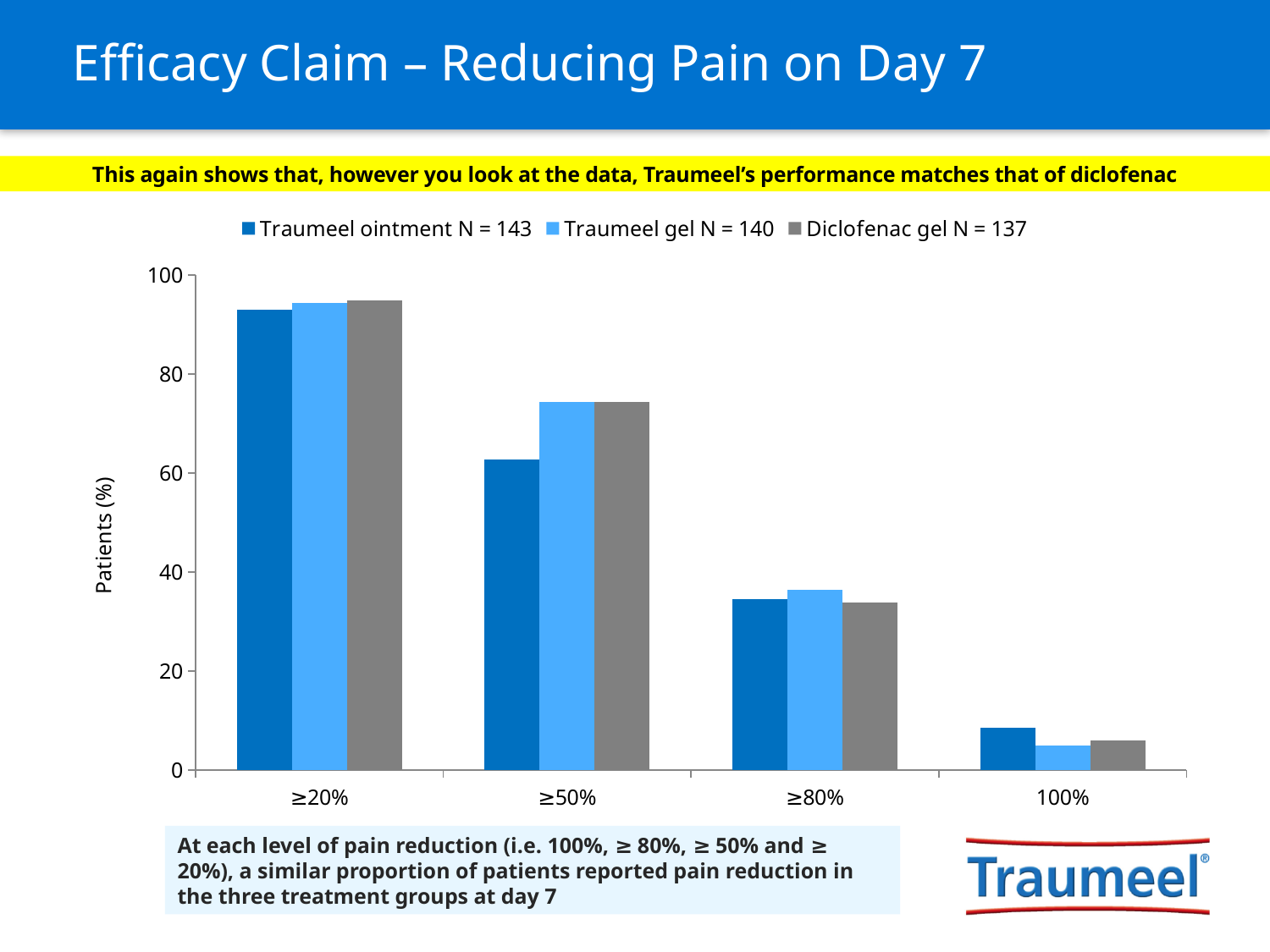
At ≥50%, which is larger: Traumeel ointment or Traumeel gel? Traumeel gel For Diclofenac gel, which category has the lowest value? 100% What kind of chart is shown on the slide? bar chart Is the value for Traumeel ointment at ≥50% greater or less than 60? greater Do the values for Traumeel gel rise or fall from ≥20% to 100% along the x axis? fall At 100%, which is larger: Traumeel ointment or Traumeel gel? Traumeel ointment Is the value for Traumeel gel at ≥80% greater or less than 40? less Is the value for Diclofenac gel at 100% greater or less than 20? less How many series does the legend list? 3 How many pain-reduction categories are shown on the x axis? 4 For Traumeel ointment, which category has the highest value? ≥20%